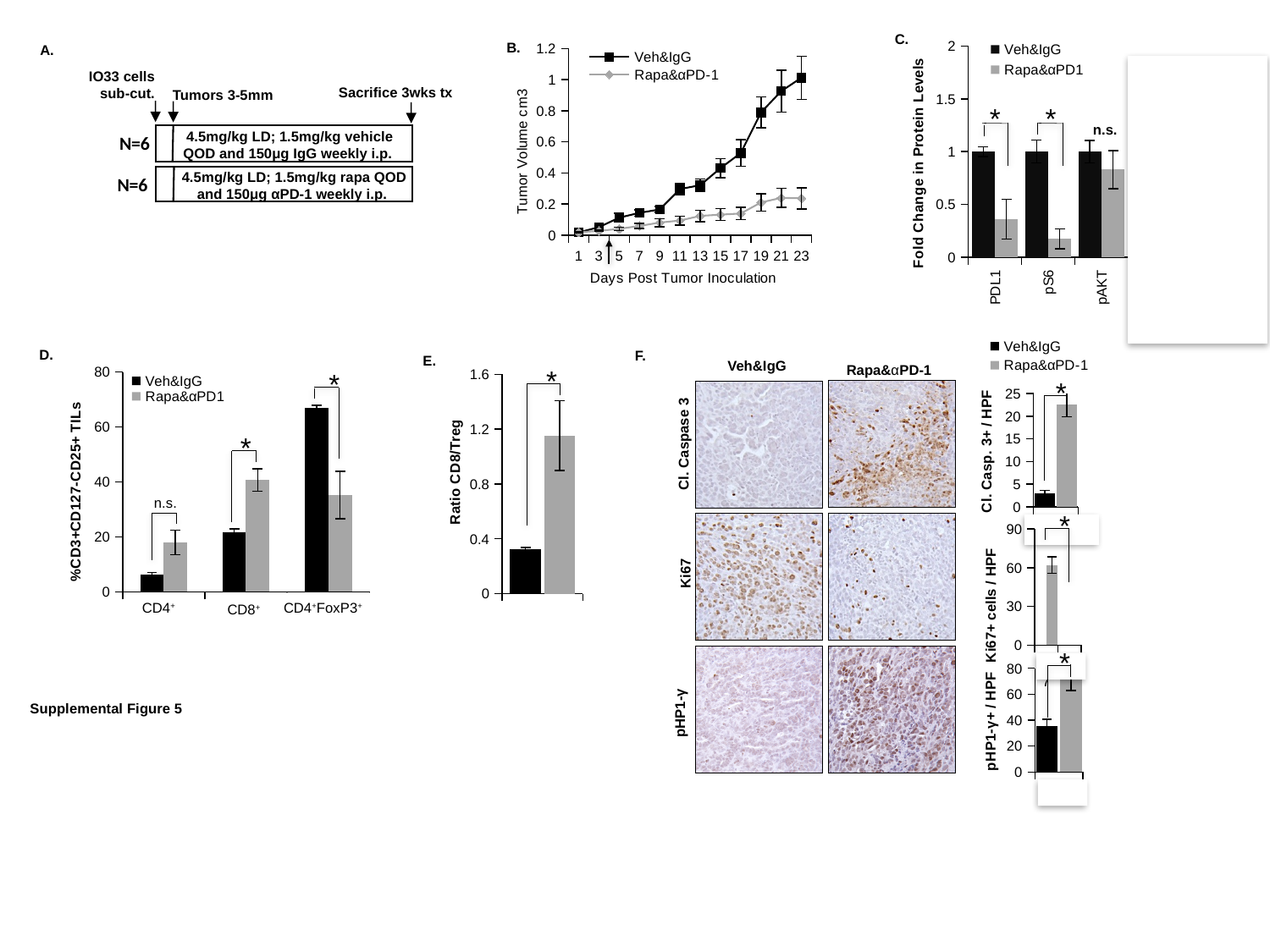
In chart C, is the fold change for Rapa&αPD1 at pS6 greater or less than 0.5? less In chart B (Tumor Volume cm3 vs Days Post Tumor Inoculation), what kind of chart is shown? line chart In the Cl. Casp. 3+ / HPF chart in panel F, is the value for Veh&IgG greater or less than 5? less In chart C, for which protein is the Rapa&αPD1 fold change lowest? pS6 In chart E (Ratio CD8/Treg), is the value for Rapa&αPD-1 greater or less than 0.8? greater In chart C (Fold Change in Protein Levels), how many protein categories are shown on the x axis? 3 In chart D (%CD3+CD127-CD25+ TILs), for which category is the Veh&IgG value highest? CD4+FoxP3+ In chart D, for CD8+, which series has the larger value, Veh&IgG or Rapa&αPD1? Rapa&αPD1 In chart B, at day 23, which series has the larger tumor volume, Veh&IgG or Rapa&αPD-1? Veh&IgG In chart B, how many series does the legend list? 2 In chart B, does the tumor volume for Veh&IgG rise or fall as days post tumor inoculation increase? rise